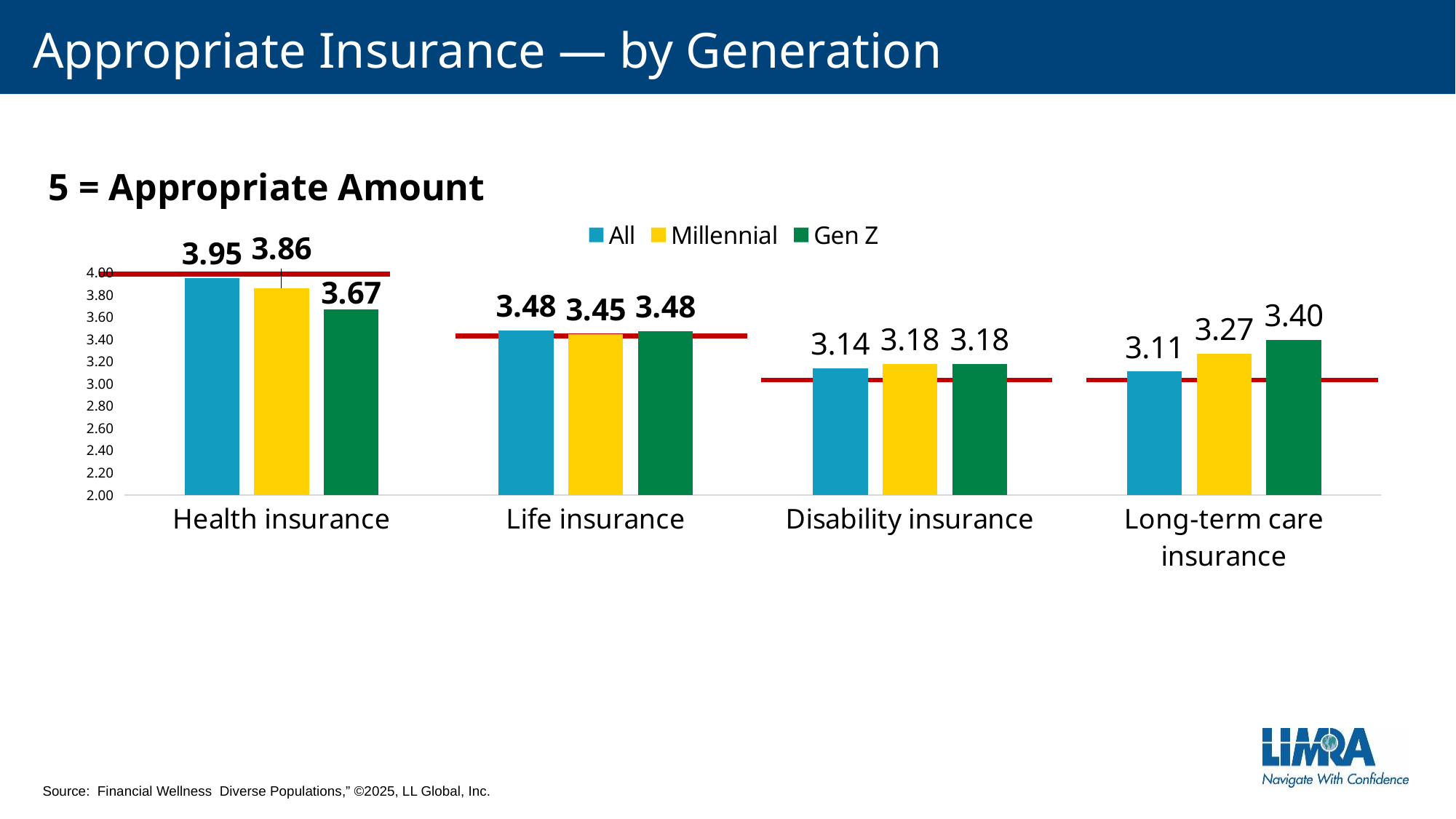
What kind of chart is shown on the slide? Bar chart What is the difference between the All value and the Gen Z value for Health insurance? 0.28 How many series does the legend list? 3 What is the value for Gen Z for Health insurance? 3.67 How many insurance categories are shown on the x axis? 4 What is the value for Millennial for Long-term care insurance? 3.27 Is the value for Millennial for Health insurance greater or less than 3.60? greater For Long-term care insurance, which is larger: the Millennial value or the Gen Z value? Gen Z Which insurance category has the highest value for All? Health insurance Which insurance category has the lowest value for Gen Z? Disability insurance What is the value for All for Disability insurance? 3.14 What is the difference between the Gen Z value and the All value for Long-term care insurance? 0.29